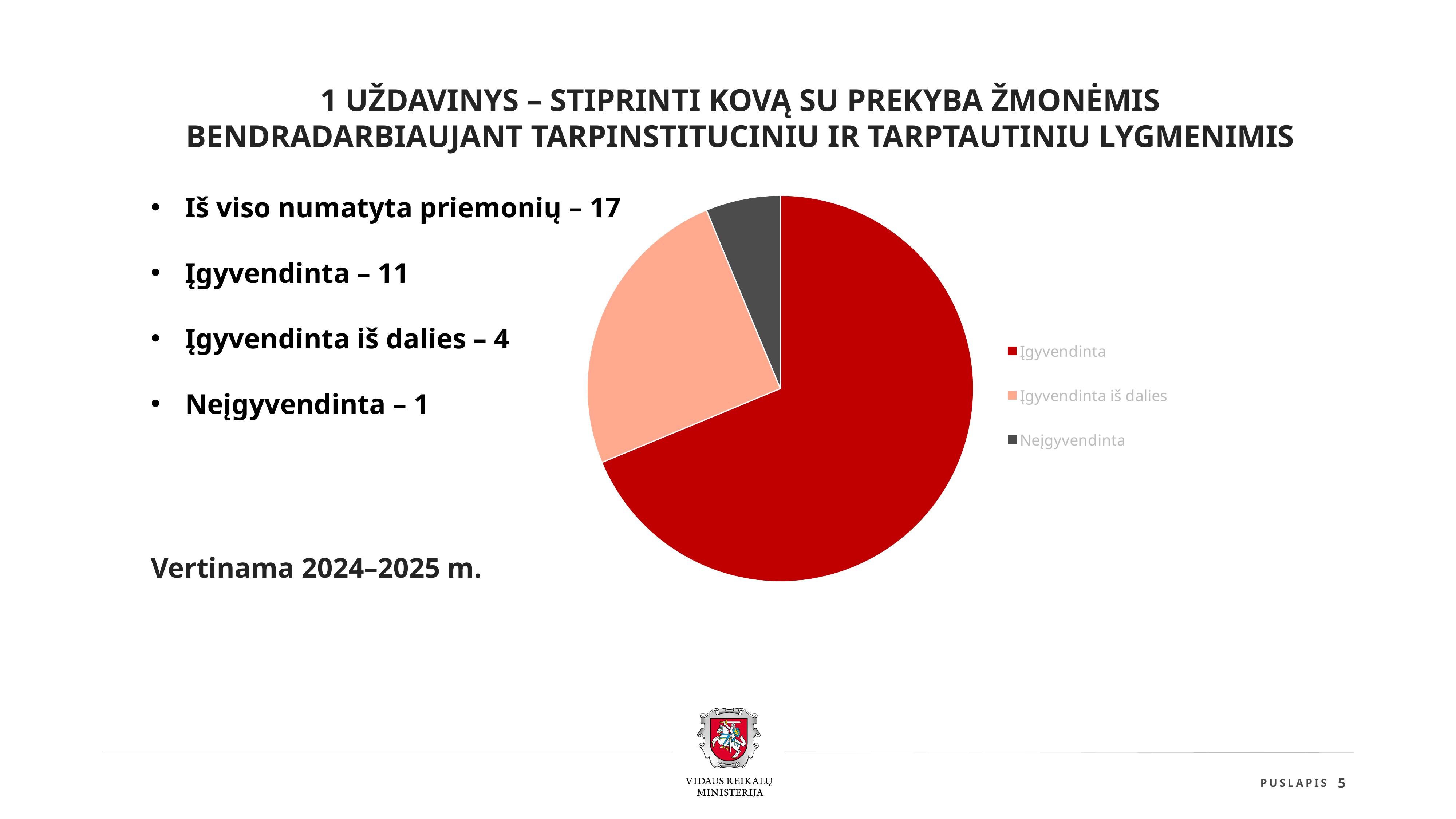
Which category has the largest slice in the pie chart? Įgyvendinta What kind of chart is shown on the slide? pie chart Which slice is larger in the pie chart: Įgyvendinta or Įgyvendinta iš dalies? Įgyvendinta Which category has the smallest slice in the pie chart? Neįgyvendinta What is the value for Įgyvendinta iš dalies shown on the slide? 4 How many entries does the legend of the pie chart list? 3 How many slices does the pie chart have? 3 What colour is the Neįgyvendinta slice in the pie chart? dark grey Which slice is larger in the pie chart: Įgyvendinta iš dalies or Neįgyvendinta? Įgyvendinta iš dalies What is the value for Įgyvendinta shown on the slide? 11 By how much does the value for Įgyvendinta exceed the value for Įgyvendinta iš dalies? 7 What is the value for Neįgyvendinta shown on the slide? 1